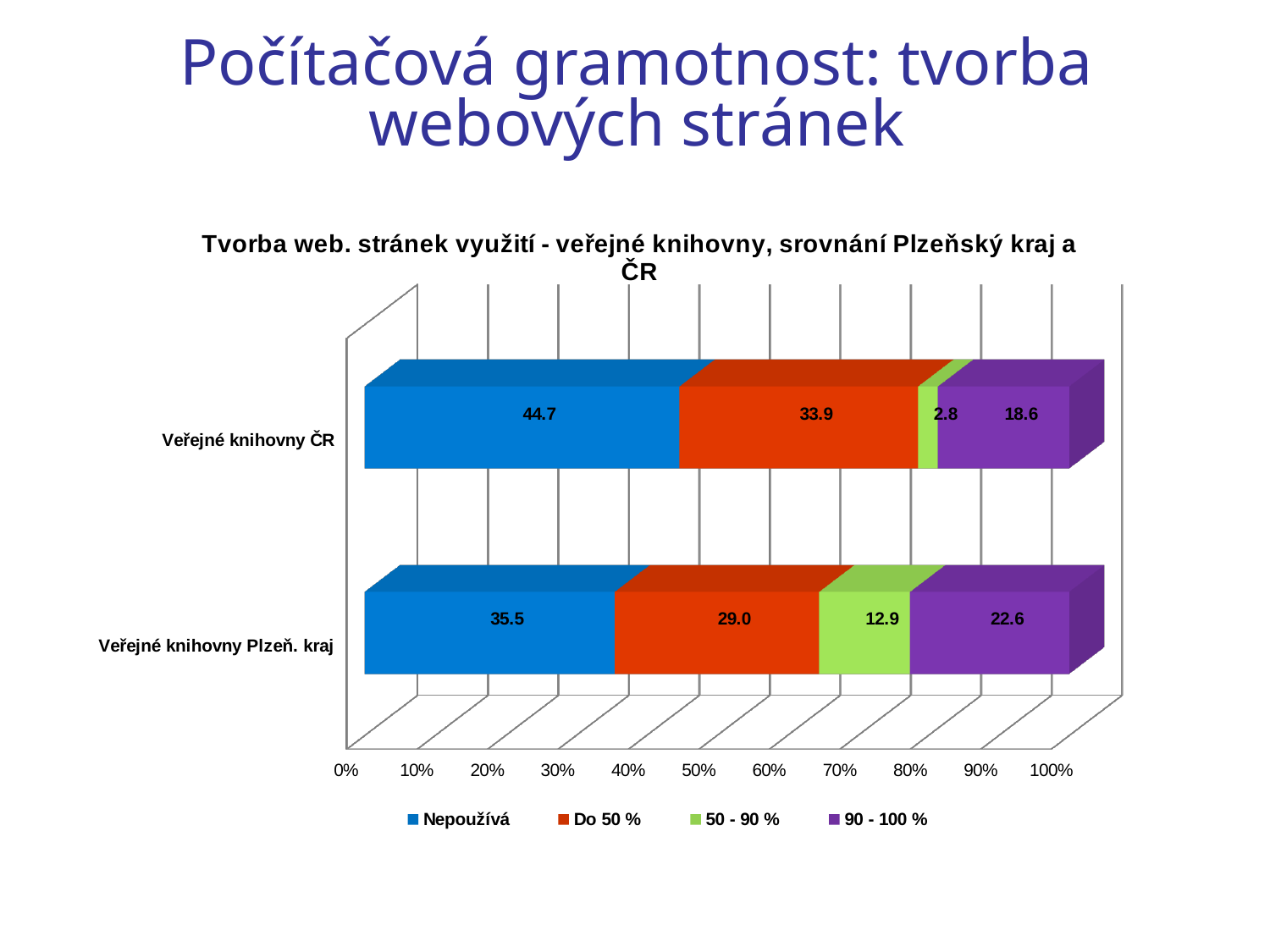
What is the value of '50 - 90 %' for Veřejné knihovny Plzeň. kraj? 12.9 What is the difference between the '50 - 90 %' values for Veřejné knihovny Plzeň. kraj and Veřejné knihovny ČR? 10.1 What is the value of '90 - 100 %' for Veřejné knihovny ČR? 18.6 What is the value of 'Nepoužívá' for Veřejné knihovny ČR? 44.7 Which category has the higher value for 'Nepoužívá'? Veřejné knihovny ČR Which series has the highest value for Veřejné knihovny Plzeň. kraj? Nepoužívá What is the title of the chart? Tvorba web. stránek využití - veřejné knihovny, srovnání Plzeňský kraj a ČR How many series does the legend list? 4 What is the value of 'Do 50 %' for Veřejné knihovny Plzeň. kraj? 29.0 Which series has the lowest value for Veřejné knihovny ČR? 50 - 90 % How many categories are shown on the vertical axis? 2 What type of chart is shown on the slide? stacked bar chart